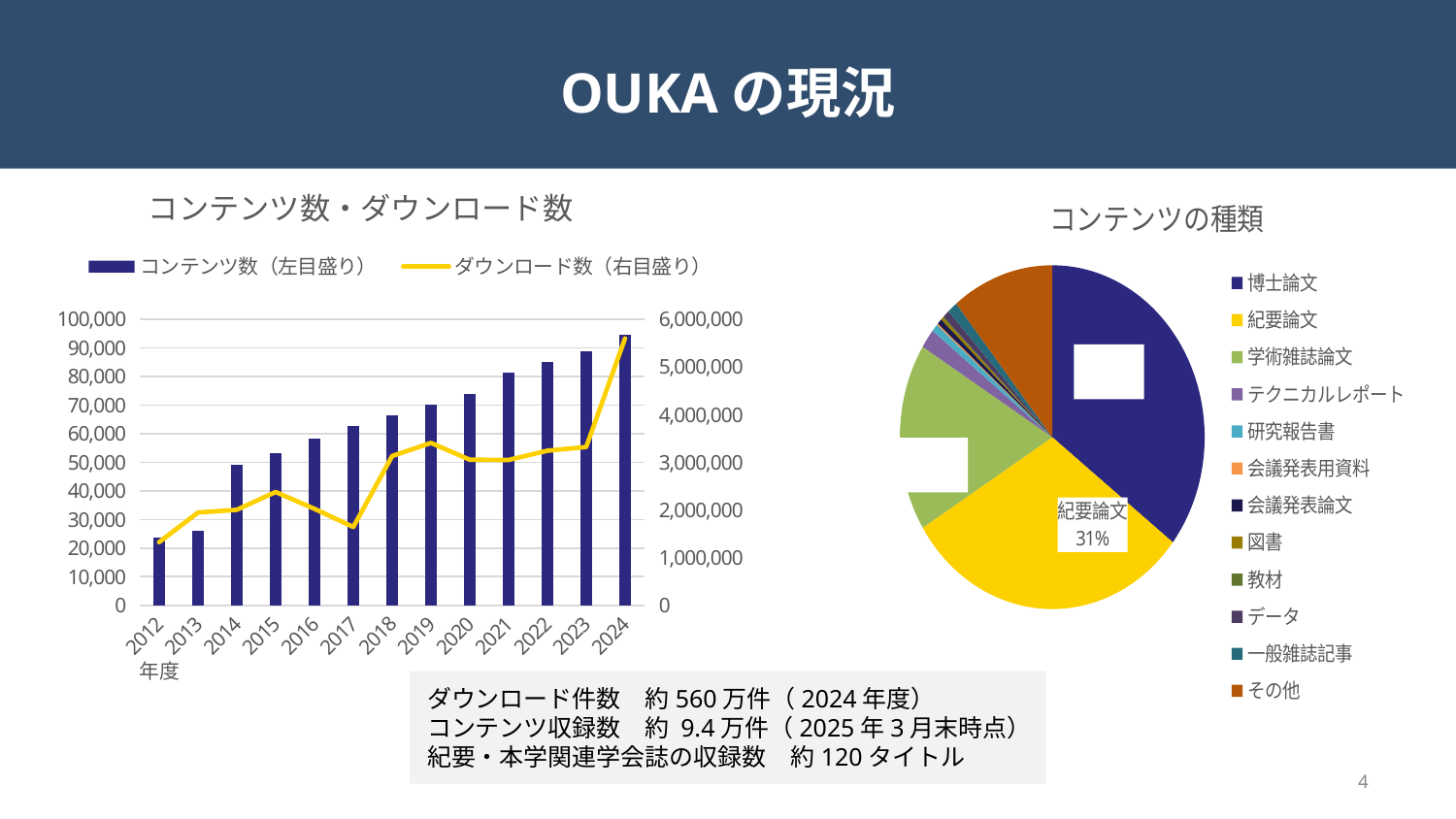
In the left chart (コンテンツ数・ダウンロード数), is the コンテンツ数 value for 2012 greater or less than 30,000? less In the left chart (コンテンツ数・ダウンロード数), do the コンテンツ数 bars rise or fall from 2012 to 2024? rise In the left chart (コンテンツ数・ダウンロード数), which year has the higher コンテンツ数, 2018 or 2019? 2019 What kind of chart is the right chart titled コンテンツの種類? A pie chart In the left chart (コンテンツ数・ダウンロード数), how many series does the legend list? 2 In the left chart (コンテンツ数・ダウンロード数), how many years are shown on the x axis? 13 In the right chart (コンテンツの種類), how many categories does the legend list? 12 In the left chart (コンテンツ数・ダウンロード数), is the ダウンロード数 value for 2017 greater or less than 2,000,000? less In the left chart (コンテンツ数・ダウンロード数), is the ダウンロード数 value for 2024 greater or less than 5,000,000? greater In the right chart (コンテンツの種類), what share of the pie is 紀要論文? 31% What kind of chart is the left chart titled コンテンツ数・ダウンロード数? A combination bar and line chart